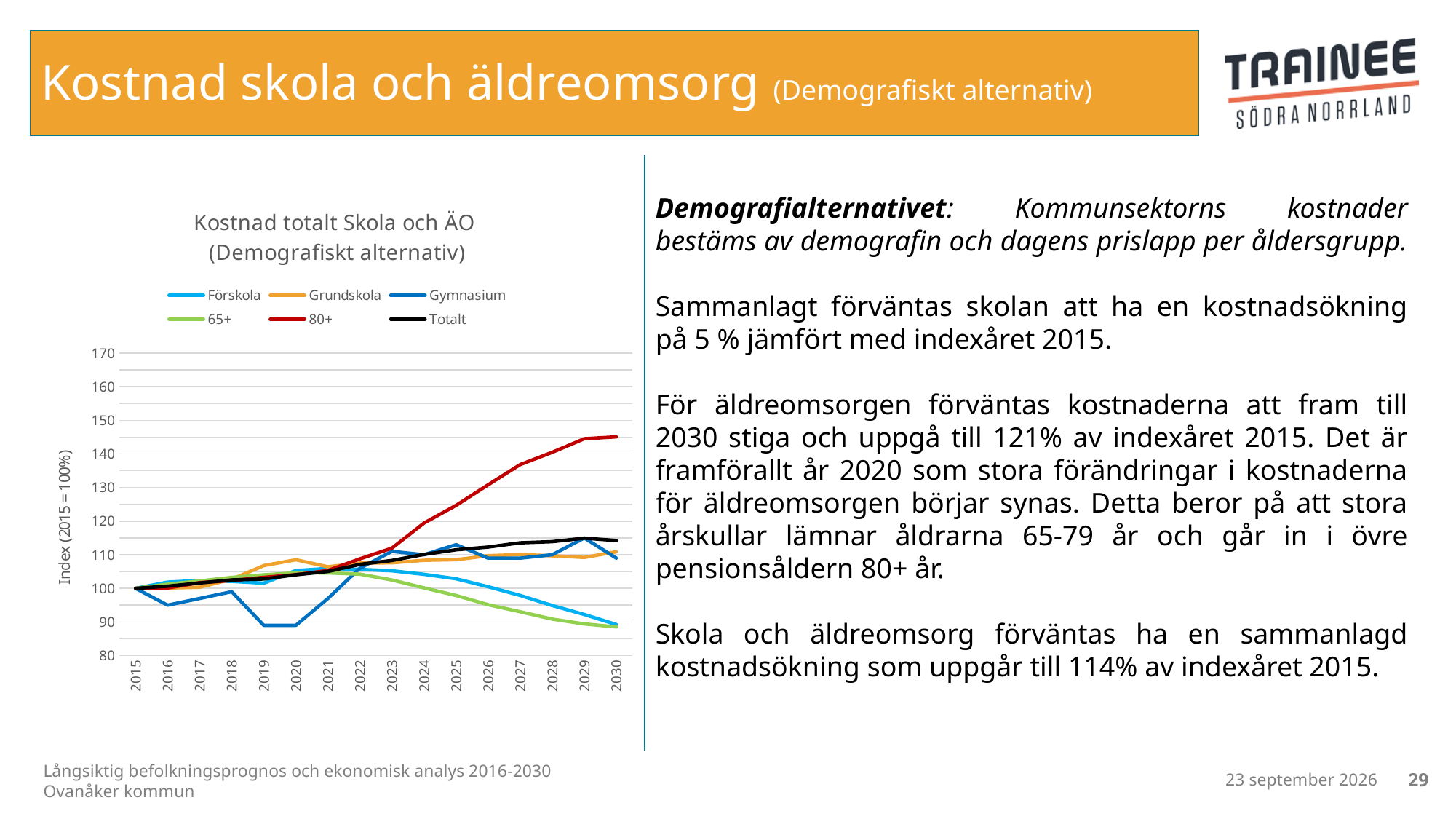
Which series has the lowest value in 2019? Gymnasium Is the value for 80+ in 2030 greater or less than 140? greater Which series has the highest value in 2030? 80+ Does the 80+ series rise or fall from 2015 to 2030? rise What kind of chart is shown on the slide? line chart How many series does the chart legend list? 6 What is the index value for Totalt in 2015? 100 Is the value for Totalt in 2030 greater or less than 110? greater What is the label on the y axis of the chart? Index (2015 = 100%) In 2030, which is larger: the value for 80+ or the value for Förskola? 80+ Is the value for Gymnasium in 2019 greater or less than 100? less How many years are shown along the x axis of the chart? 16